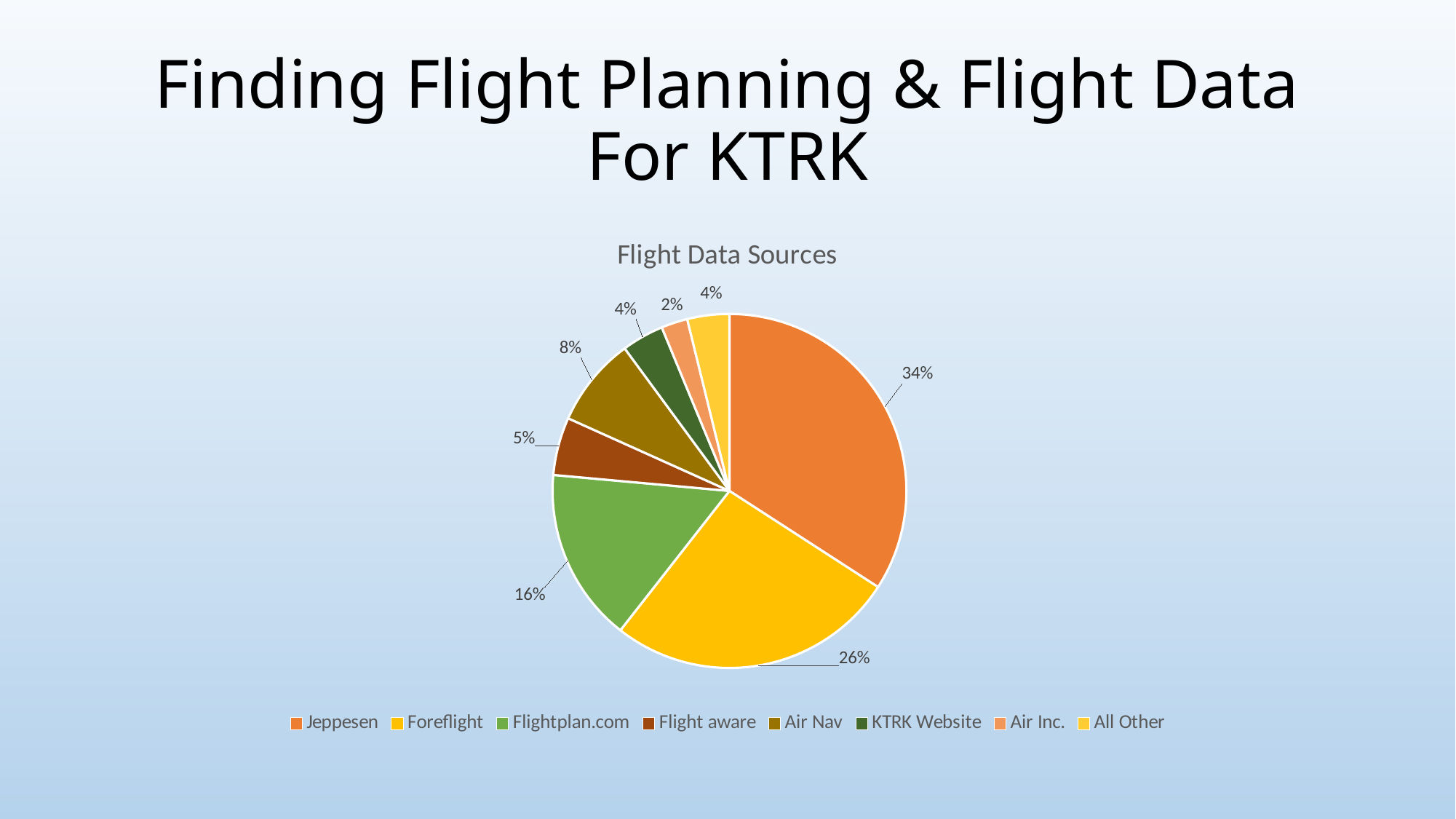
What is the title of the chart? Flight Data Sources What share of the pie does Jeppesen have? 34% Which flight data source has the smallest share of the pie? Air Inc. What share of the pie does Air Inc. have? 2% What share of the pie does Foreflight have? 26% Which has a larger share, Flight aware or Air Nav? Air Nav What share of the pie does Air Nav have? 8% How many categories does the legend list? 8 What share of the pie does Flightplan.com have? 16% What is the difference between the shares of Jeppesen and Foreflight? 8% Which flight data source has the largest share of the pie? Jeppesen What type of chart is shown on the slide? Pie chart